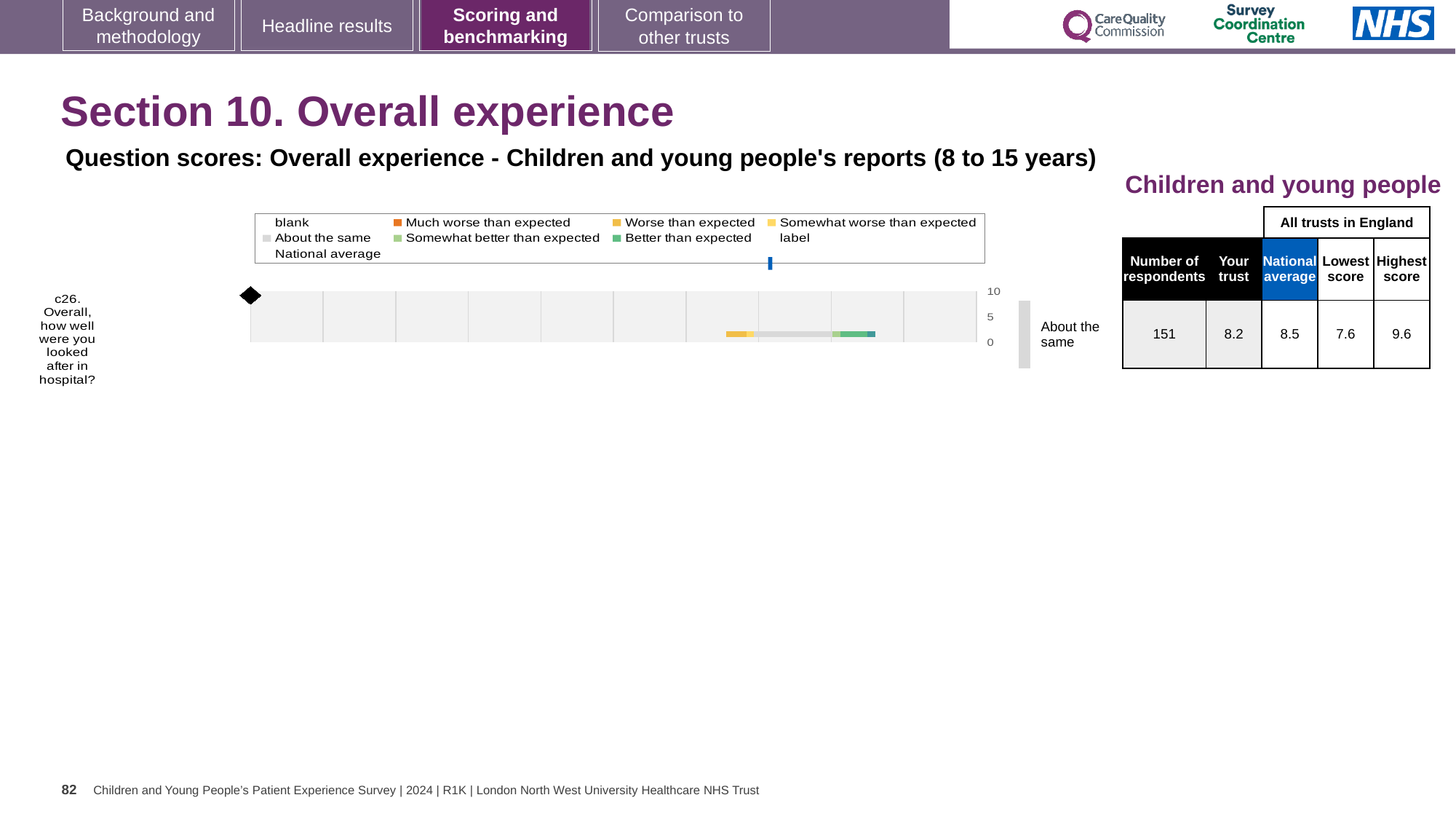
What is the label of the question plotted in the chart? c26. Overall, how well were you looked after in hospital? What benchmark category is shown to the right of the bar for c26? About the same How many respondents are listed for c26? 151 What is the 'Your trust' score for c26 in the table? 8.2 What is the Lowest score among all trusts in England for c26? 7.6 Which is larger for c26, the 'Your trust' score or the National average? National average How many survey questions are plotted in the chart? 1 What is the difference between the Highest score and the Lowest score for c26? 2.0 What is the difference between the National average and the 'Your trust' score for c26? 0.3 What is the Highest score among all trusts in England for c26? 9.6 What is the National average score for c26 in the table? 8.5 What kind of chart is shown on the slide? bar chart